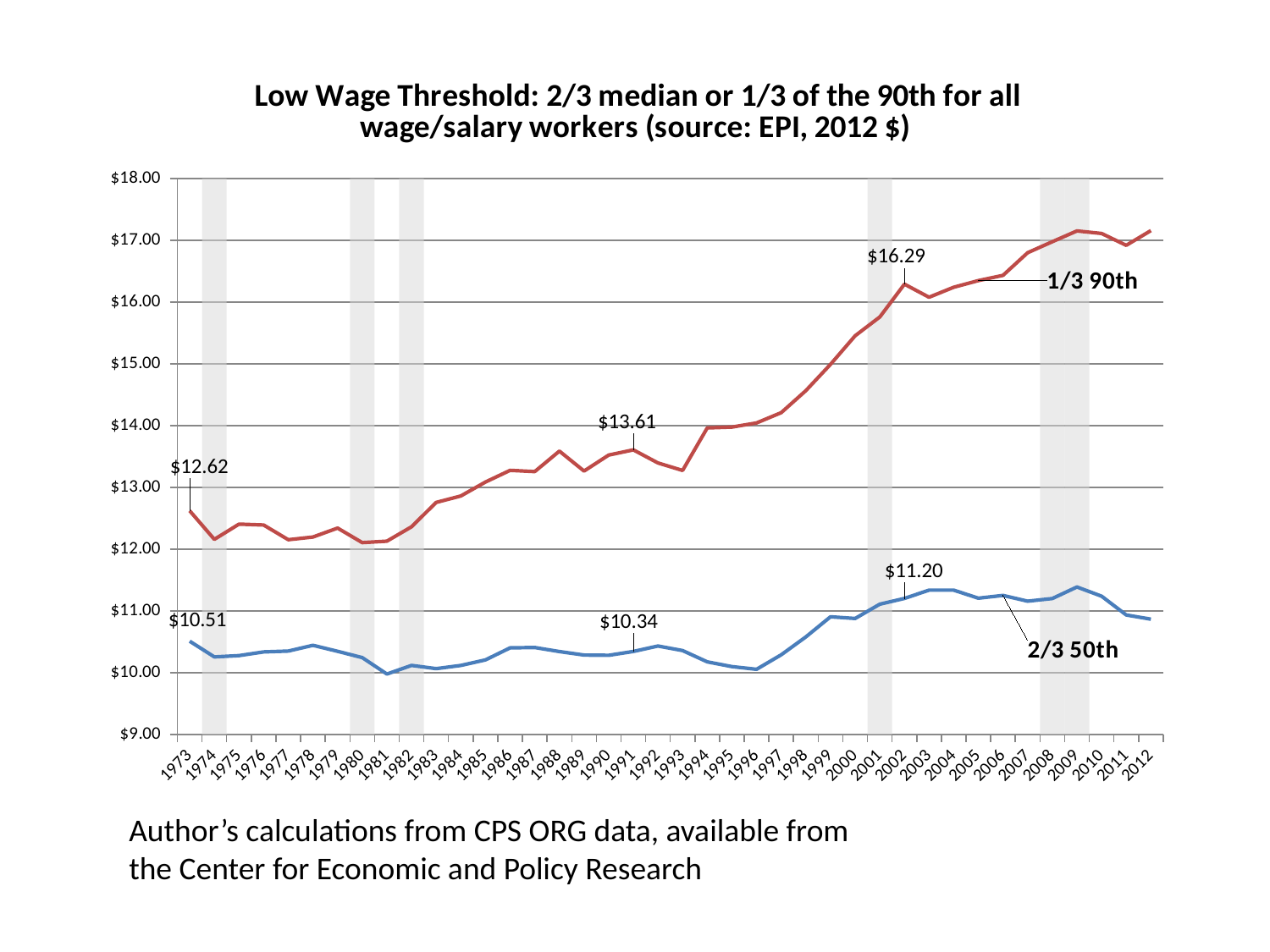
How many series are plotted on the chart? 2 What is the difference between the 1/3 90th value in 2002 and its value in 1973? $3.67 What type of chart is shown on the slide? Line chart What is the value of the 2/3 50th series in 1973? $10.51 What is the difference between the 1/3 90th and 2/3 50th values in 2002? $5.09 What is the value of the 2/3 50th series in 2002? $11.20 Does the 1/3 90th series generally rise or fall from 1973 to 2012? Rise Which series has the higher value in 1991, 1/3 90th or 2/3 50th? 1/3 90th What is the value of the 1/3 90th series in 1973? $12.62 Is the value of the 1/3 90th series in 2012 greater or less than $17.00? greater What is the value of the 1/3 90th series in 2002? $16.29 What is the value of the 1/3 90th series in 1991? $13.61